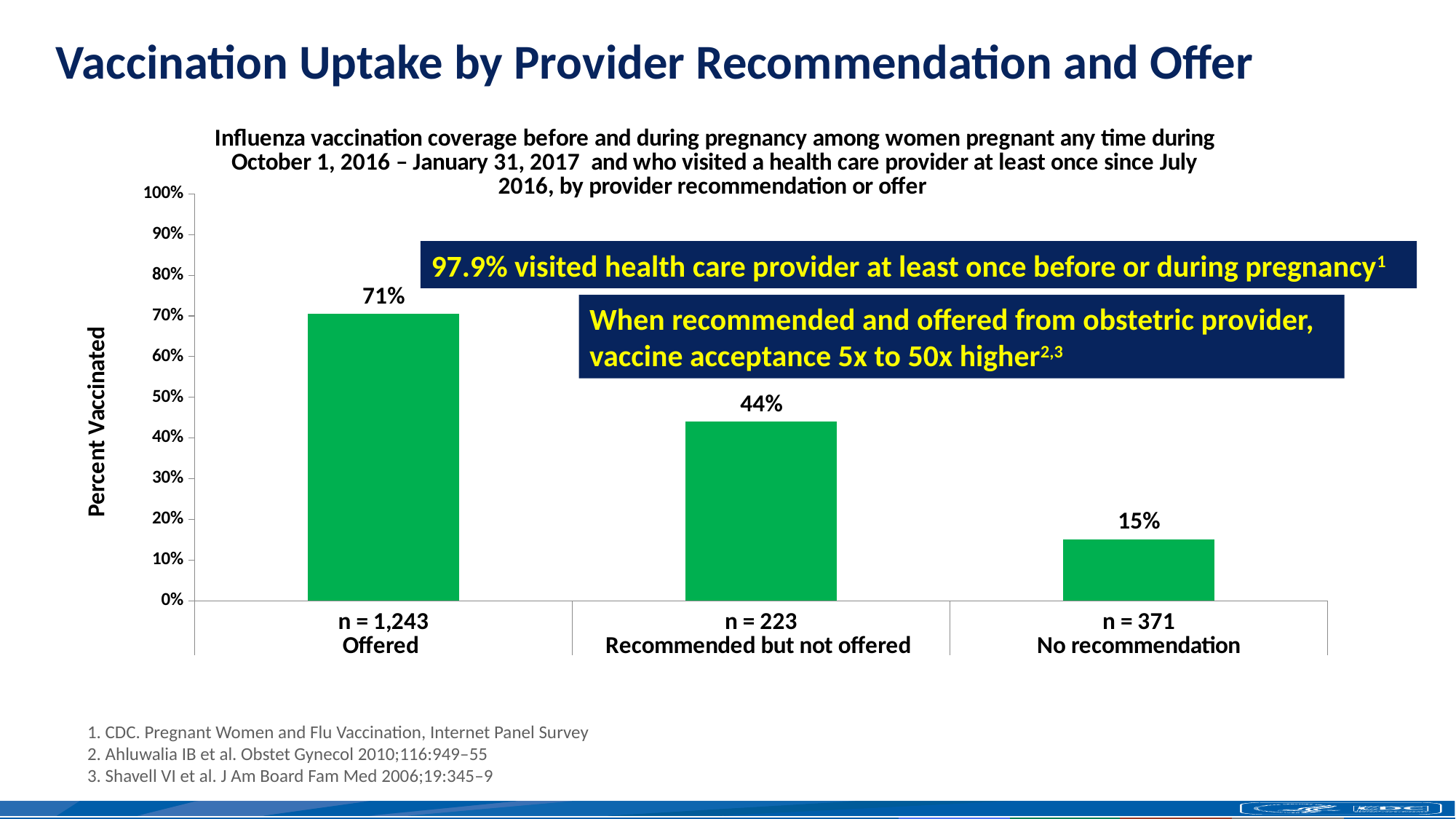
What is the percent vaccinated for the 'No recommendation' category? 15% Is the value for 'Recommended but not offered' greater or less than 50%? less Which category has the highest percent vaccinated? Offered What is the sample size (n) for the 'Offered' category? n = 1,243 What is the difference in percent vaccinated between 'Offered' and 'Recommended but not offered'? 27% How many categories are shown on the chart? 3 Which category has the lowest percent vaccinated? No recommendation What is the difference in percent vaccinated between 'Offered' and 'No recommendation'? 56% What kind of chart is shown on the slide? Bar chart What is the percent vaccinated for the 'Recommended but not offered' category? 44% What is the percent vaccinated for the 'Offered' category? 71% Which has a higher percent vaccinated, 'Recommended but not offered' or 'No recommendation'? Recommended but not offered